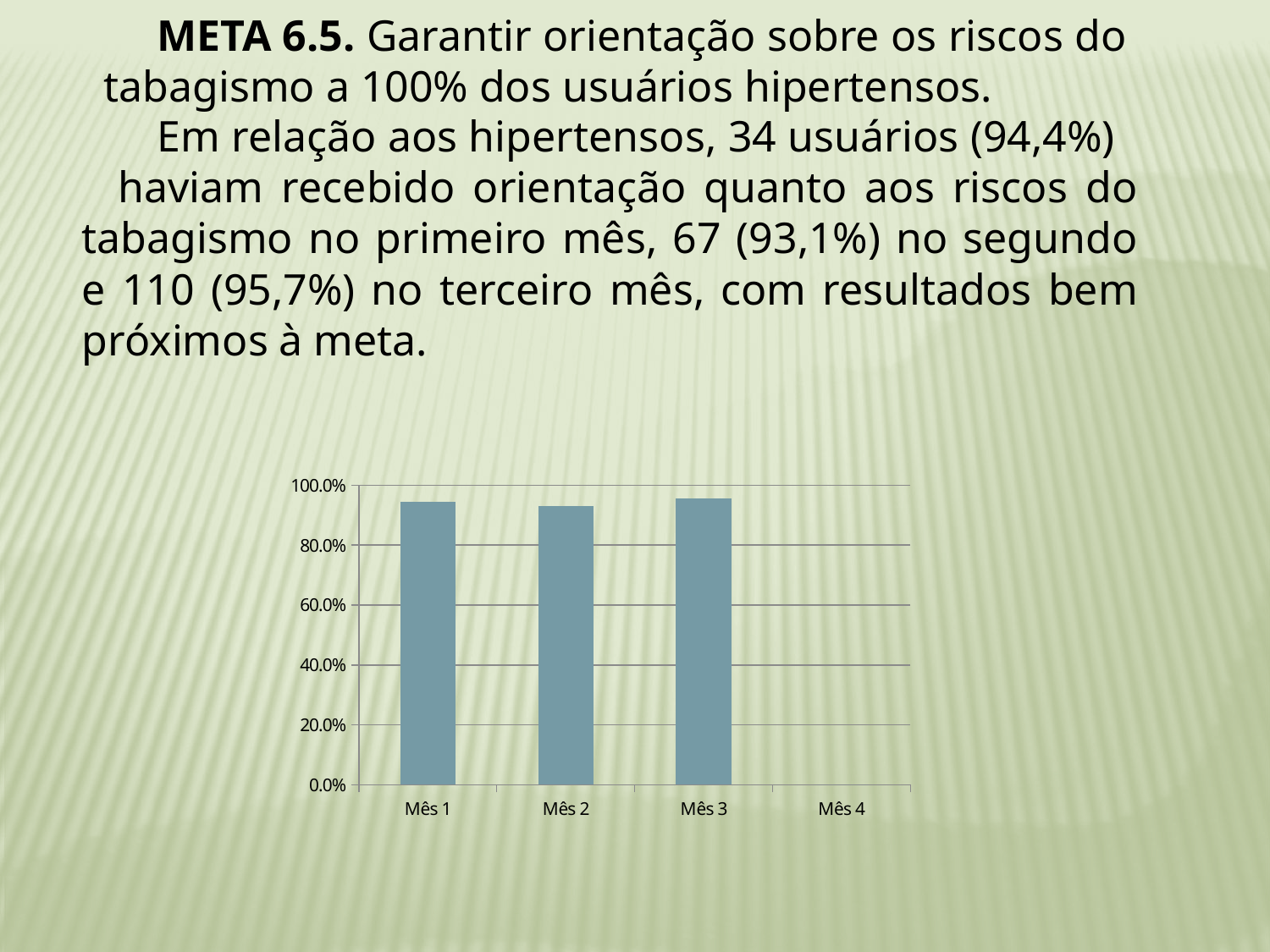
Is the value for Mês 1 greater or less than 80.0%? greater Is the value for Mês 3 greater or less than 100.0%? less How many category labels appear on the x axis of the chart? 4 Is the value for Mês 3 greater or less than 80.0%? greater What is the highest tick label shown on the y axis of the chart? 100.0% How many bars are plotted in the chart? 3 Which x-axis category has no bar plotted? Mês 4 What kind of chart is shown on the slide? bar chart What is the label of the first category on the x axis? Mês 1